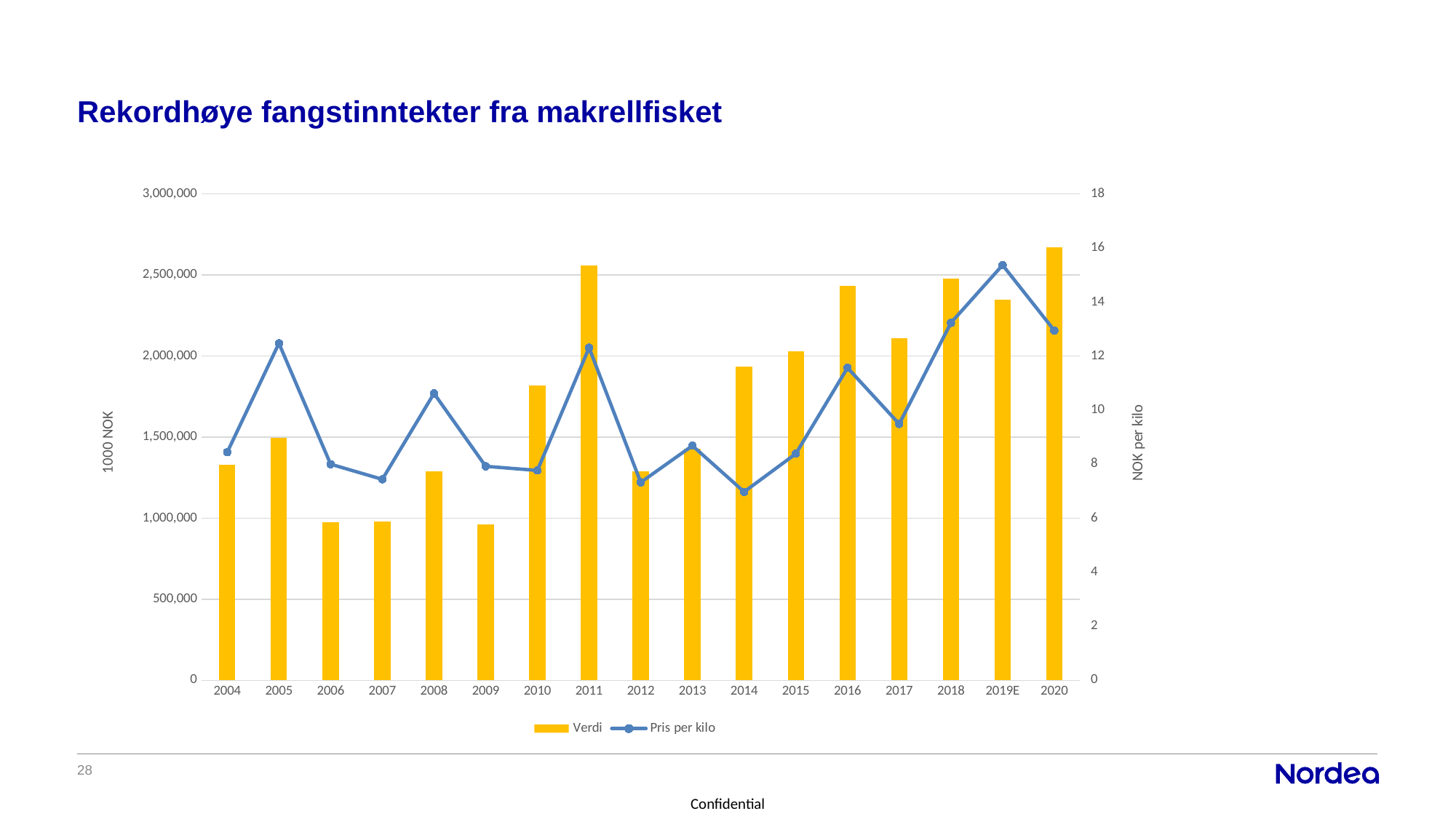
Which year has the highest Pris per kilo value? 2019E Does the Pris per kilo line rise or fall from 2016 to 2017? fall Which year has the highest Verdi bar? 2020 Is the Verdi value for 2010 greater or less than 1,500,000? greater Which year has the higher Pris per kilo, 2008 or 2009? 2008 Is the Pris per kilo value for 2019E greater or less than 14? greater Is the Pris per kilo value for 2014 greater or less than 8? less How many years are shown on the x axis? 17 What kind of chart is shown on the slide? A combined bar and line chart Which year has the larger Verdi bar, 2018 or 2019E? 2018 How many series does the legend list? 2